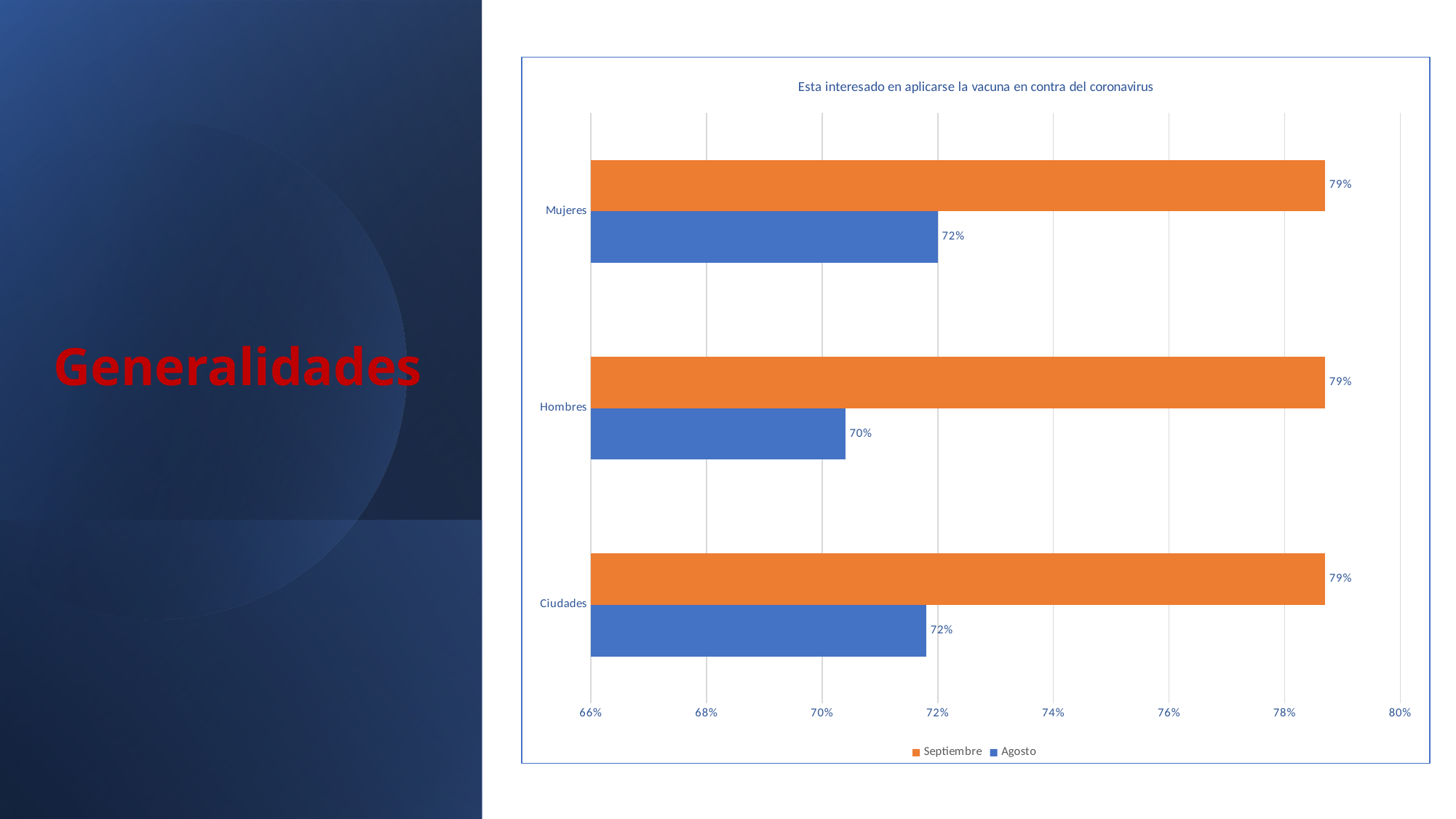
How many categories are shown on the chart? 3 What is the Agosto value for Ciudades? 72% What is the difference between the Septiembre and Agosto values for Hombres? 9 percentage points What is the difference between the Septiembre and Agosto values for Mujeres? 7 percentage points Is the Agosto value for Hombres greater or less than 72%? less What kind of chart is shown on the slide? Bar chart What is the Agosto value for Hombres? 70% Which is larger for Ciudades, the Septiembre value or the Agosto value? Septiembre What is the Septiembre value for Mujeres? 79% Which category has the lowest Agosto value? Hombres What is the Septiembre value for Hombres? 79% How many series does the legend list? 2